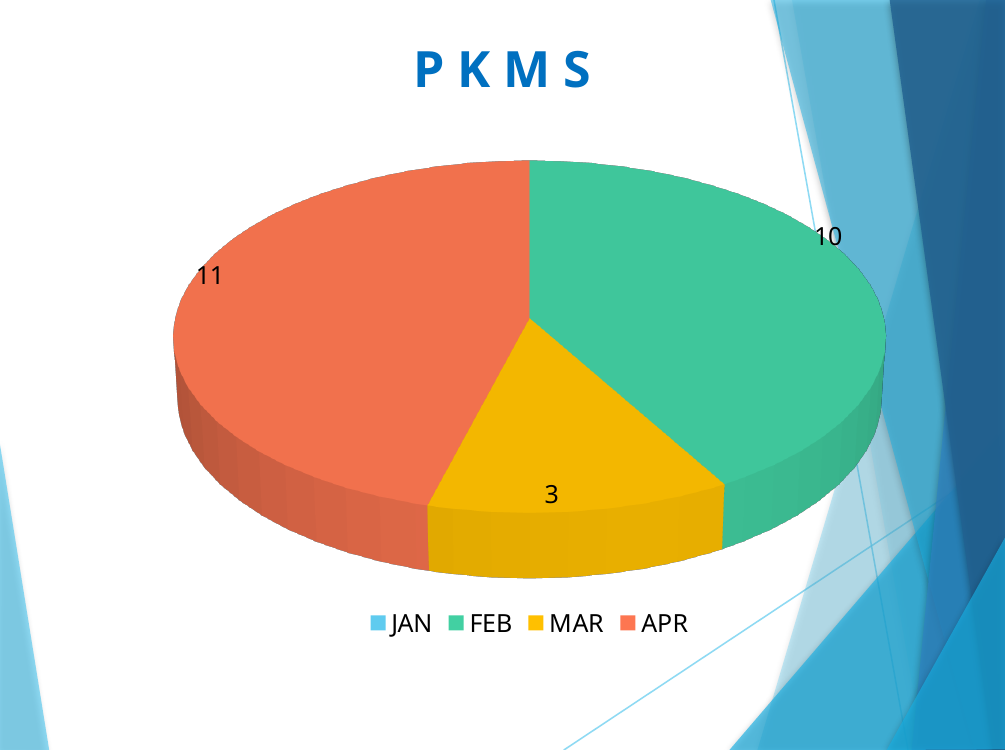
What is the difference between the APR and FEB values? 1 What is the value of the MAR slice? 3 What is the title of the chart? P K M S What colour is the APR slice? Orange What is the value of the APR slice? 11 What kind of chart is shown on the slide? Pie chart Which is larger, the FEB slice or the MAR slice? FEB What is the value of the FEB slice? 10 How many entries does the legend list? 4 What is the difference between the FEB and MAR values? 7 Which labelled slice has the largest value? APR Which labelled slice has the smallest value? MAR